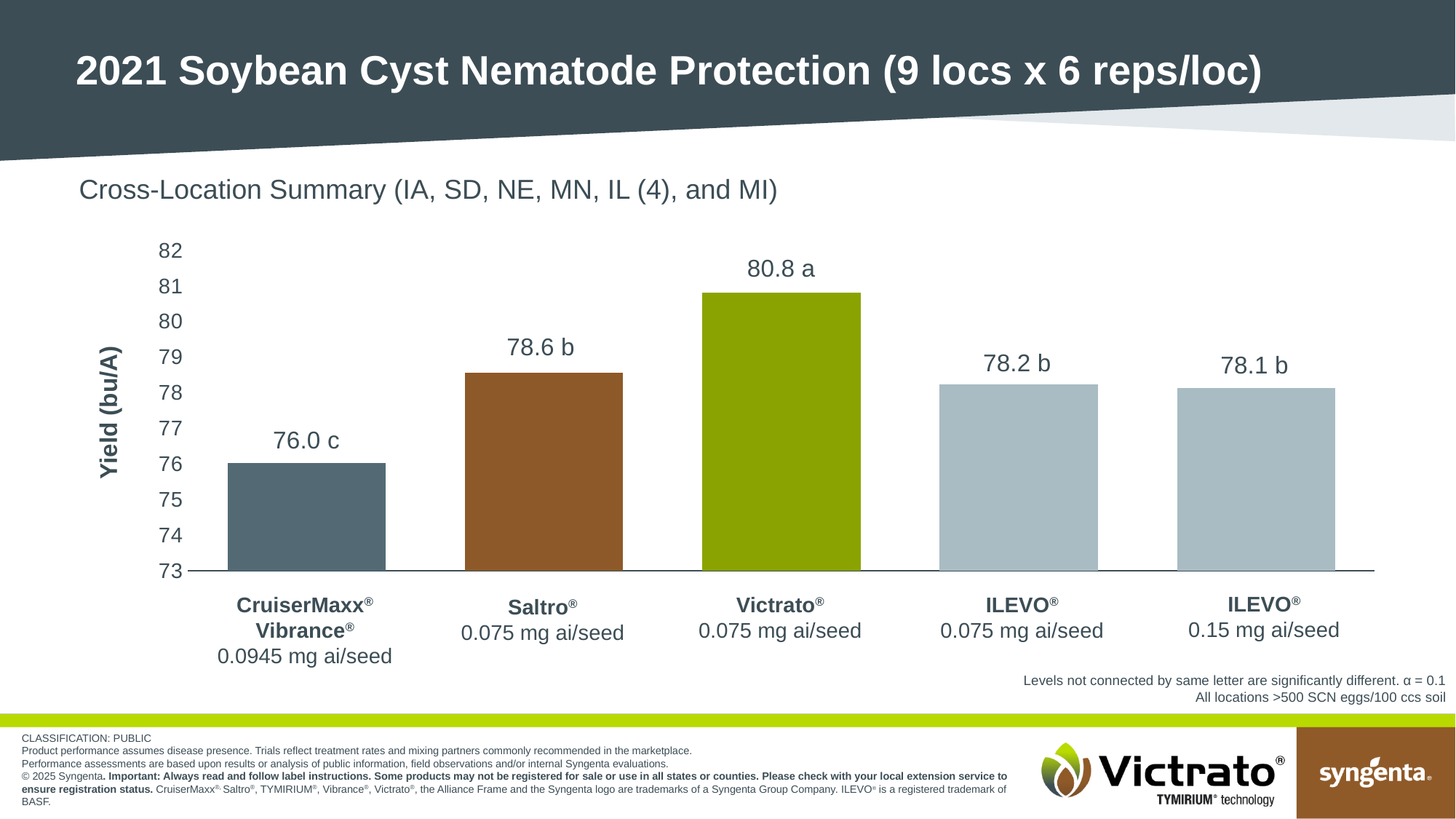
What is the yield value shown for ILEVO 0.15 mg ai/seed? 78.1 b How many treatments are shown in the chart? 5 What is the difference in yield between Victrato 0.075 mg ai/seed and CruiserMaxx Vibrance 0.0945 mg ai/seed? 4.8 Which treatment has the lowest yield? CruiserMaxx Vibrance 0.0945 mg ai/seed Which has the higher yield, Saltro 0.075 mg ai/seed or ILEVO 0.075 mg ai/seed? Saltro 0.075 mg ai/seed Is the yield for Victrato 0.075 mg ai/seed greater or less than 80? greater Which treatment has the highest yield? Victrato 0.075 mg ai/seed What is the label of the y axis? Yield (bu/A) What is the yield value shown for Victrato 0.075 mg ai/seed? 80.8 a What is the yield value shown for Saltro 0.075 mg ai/seed? 78.6 b What is the yield value shown for CruiserMaxx Vibrance 0.0945 mg ai/seed? 76.0 c What kind of chart is shown on the slide? Bar chart